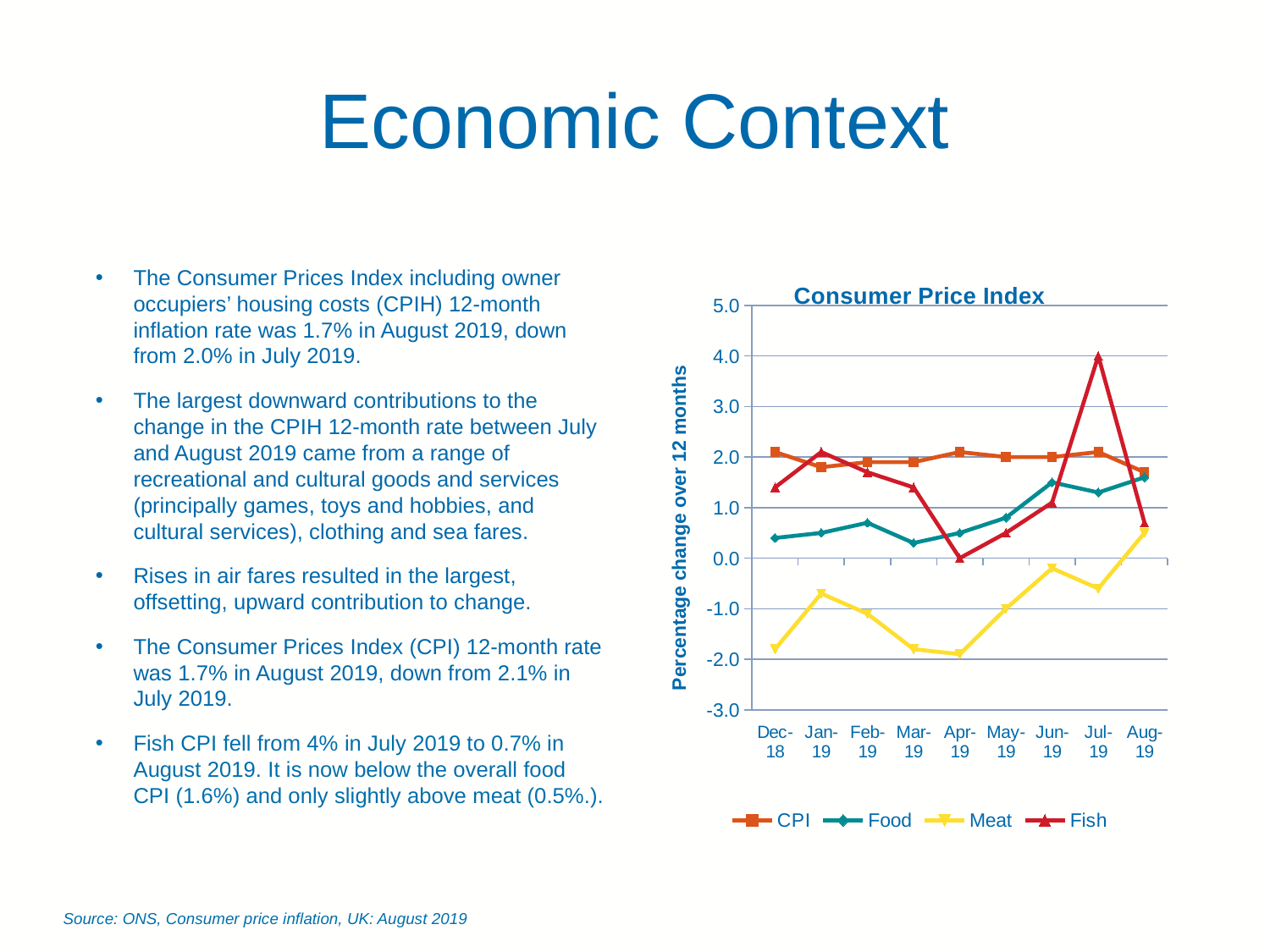
How many series does the chart legend list? 4 In which month does the Meat series reach its highest value? Aug-19 In Jul-19, which series has the larger value, Fish or CPI? Fish In which month does the Fish series reach its highest value? Jul-19 Is the value for Meat in Dec-18 greater or less than -1.0? less Does the Meat series rise or fall from Apr-19 to Aug-19? rise What type of chart is shown on the slide? line chart What is the title of the chart? Consumer Price Index In which month does the Fish series reach its lowest value? Apr-19 How many months are plotted along the x axis of the chart? 9 Is the value for Fish in Jul-19 greater or less than 3.0? greater What is the y-axis label of the chart? Percentage change over 12 months